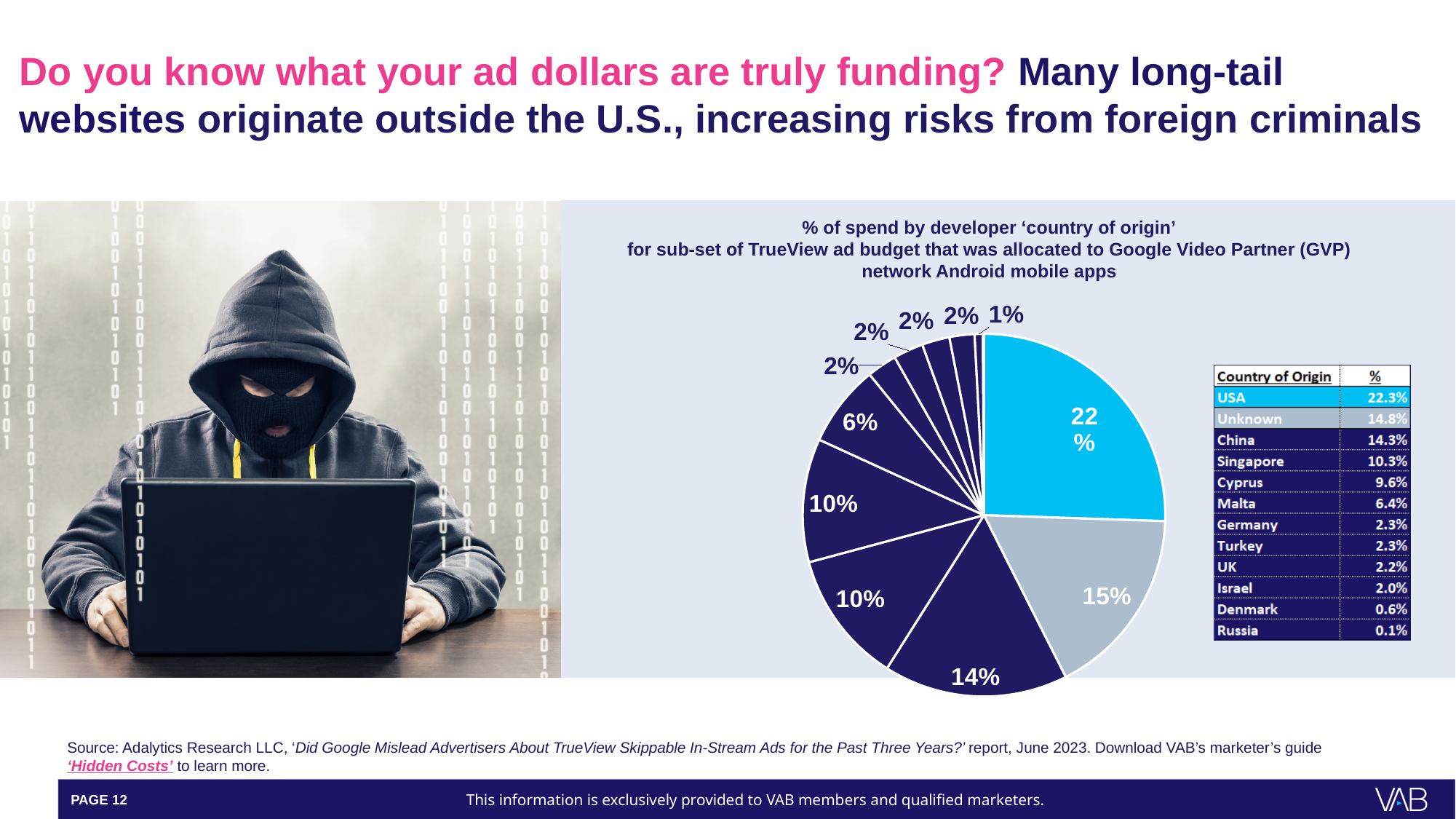
What is the first line of the chart's title? % of spend by developer 'country of origin' Which country of origin has the smallest percentage in the table? Russia According to the table, how many percentage points higher is the USA's share than China's? 8.0 percentage points What data label is shown on the grey 'Unknown' slice of the pie chart? 15% How many countries of origin are listed in the table next to the pie chart? 12 According to the table, what percentage of spend is attributed to the USA? 22.3% Which country of origin has the largest share of spend in the pie chart? USA According to the table, which has a larger share of spend, Singapore or Cyprus? Singapore According to the table, what percentage of spend is attributed to Cyprus? 9.6% What data label is shown on the largest slice of the pie chart? 22% According to the table, what percentage of spend is attributed to China? 14.3% What kind of chart is shown on the slide? Pie chart